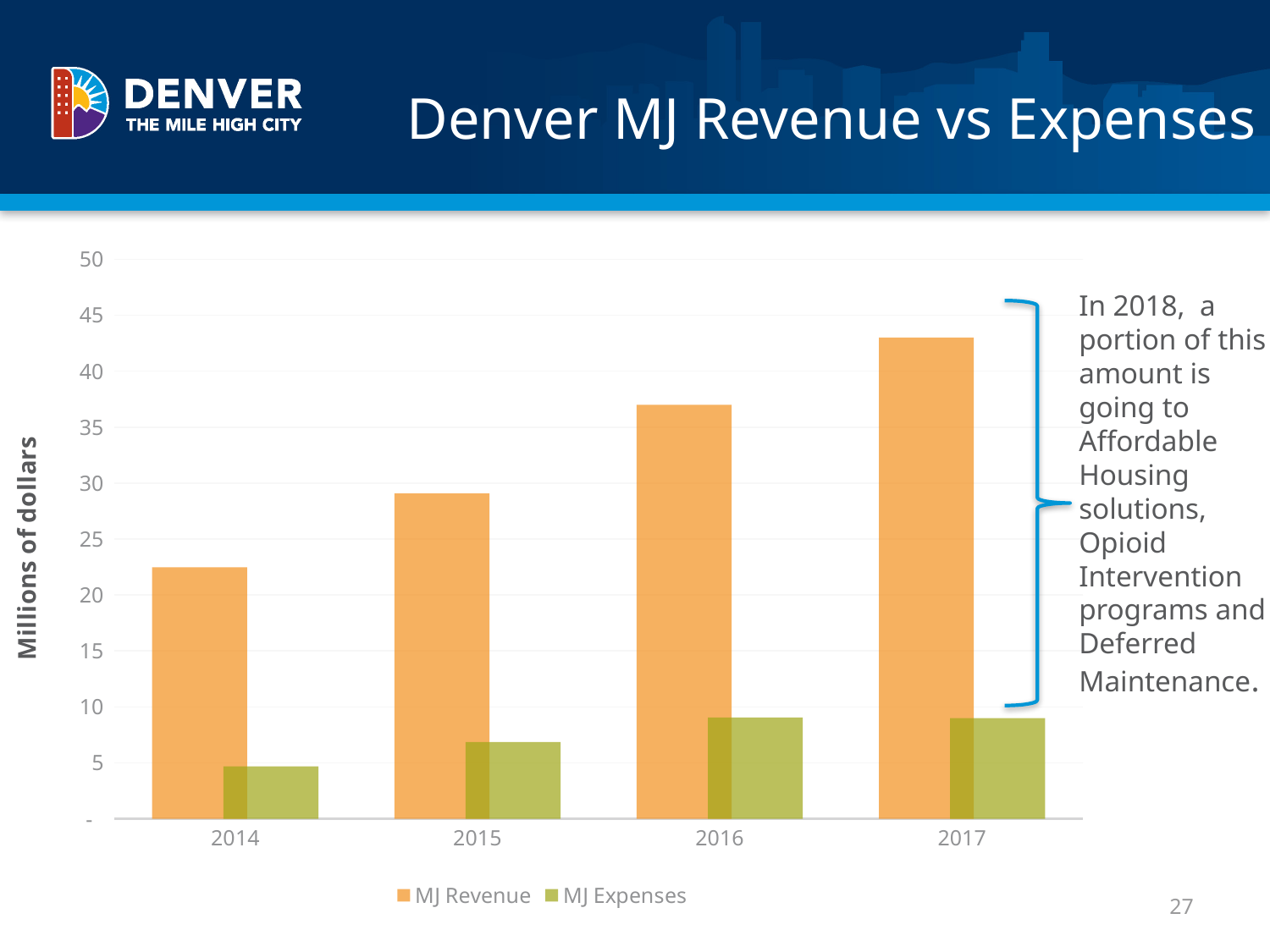
What kind of chart is shown on the slide? bar chart How many years are shown on the x axis? 4 Which year has the lowest MJ Expenses? 2014 Is the MJ Expenses value for 2015 greater or less than 10? less What is the label on the vertical axis? Millions of dollars How many series does the legend list? 2 Which is larger in 2016, MJ Revenue or MJ Expenses? MJ Revenue Is the MJ Revenue for 2017 greater or less than 40? greater Does MJ Revenue rise or fall from 2014 to 2017? rise Which year has the lowest MJ Revenue? 2014 Is the MJ Revenue for 2014 greater or less than 25? less Which year has the highest MJ Revenue? 2017